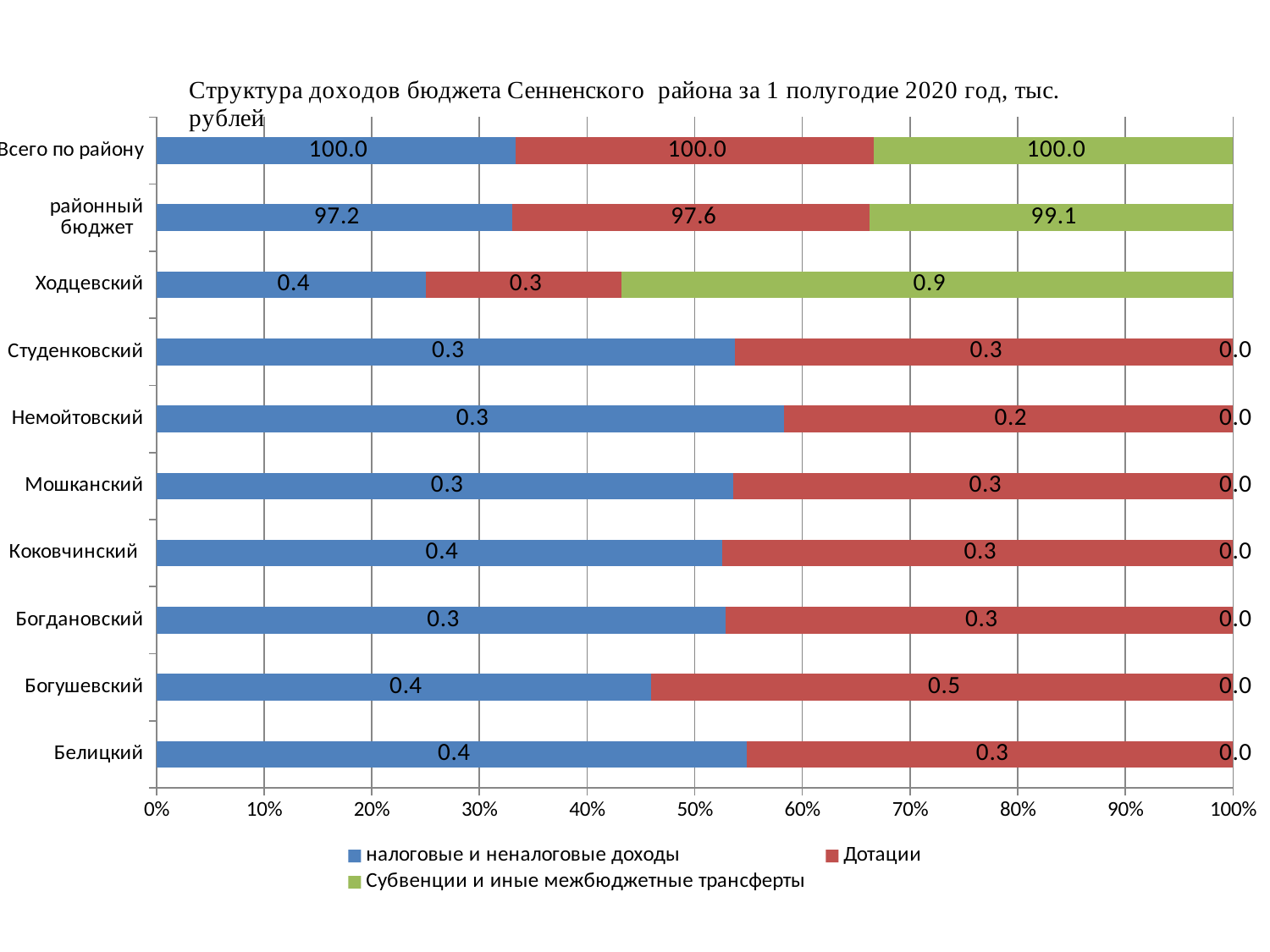
How many series does the legend list? 3 What is the value of Дотации for Богушевский? 0.5 How many categories are shown on the vertical axis of the chart? 10 Which category has the highest value for Дотации? Всего по району Which is larger: Дотации for Богушевский or Дотации for Белицкий? Богушевский What is the title of the chart? Структура доходов бюджета Сенненского района за 1 полугодие 2020 год, тыс. рублей What is the value of Субвенции и иные межбюджетные трансферты for районный бюджет? 99.1 What is the value of Дотации for Немойтовский? 0.2 What is the value of Субвенции и иные межбюджетные трансферты for Ходцевский? 0.9 What kind of chart is shown on the slide? Stacked bar chart What is the value of налоговые и неналоговые доходы for районный бюджет? 97.2 What is the difference between Субвенции и иные межбюджетные трансферты and налоговые и неналоговые доходы for районный бюджет? 1.9